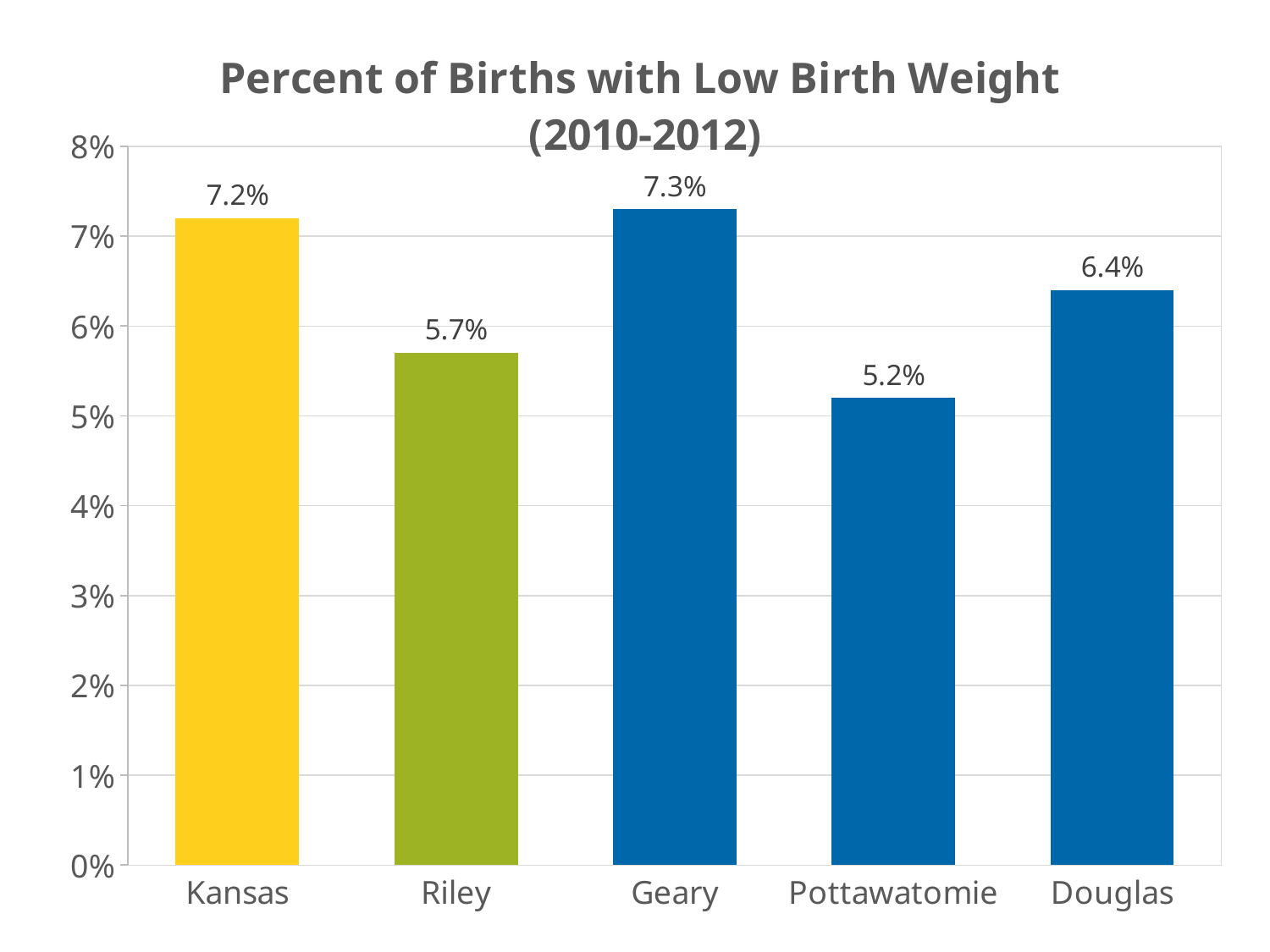
What is the percent of births with low birth weight for Riley? 5.7% Which category has the highest percent of births with low birth weight? Geary Which has a larger value, Riley or Douglas? Douglas Is the value for Geary greater or less than 7%? greater What is the difference between the values for Douglas and Pottawatomie? 1.2% What kind of chart is shown on the slide? Bar chart What is the percent of births with low birth weight for Kansas? 7.2% How many categories are shown on the chart? 5 Which category has the lowest percent of births with low birth weight? Pottawatomie What is the percent of births with low birth weight for Pottawatomie? 5.2% What is the difference between the values for Kansas and Riley? 1.5% What is the percent of births with low birth weight for Douglas? 6.4%